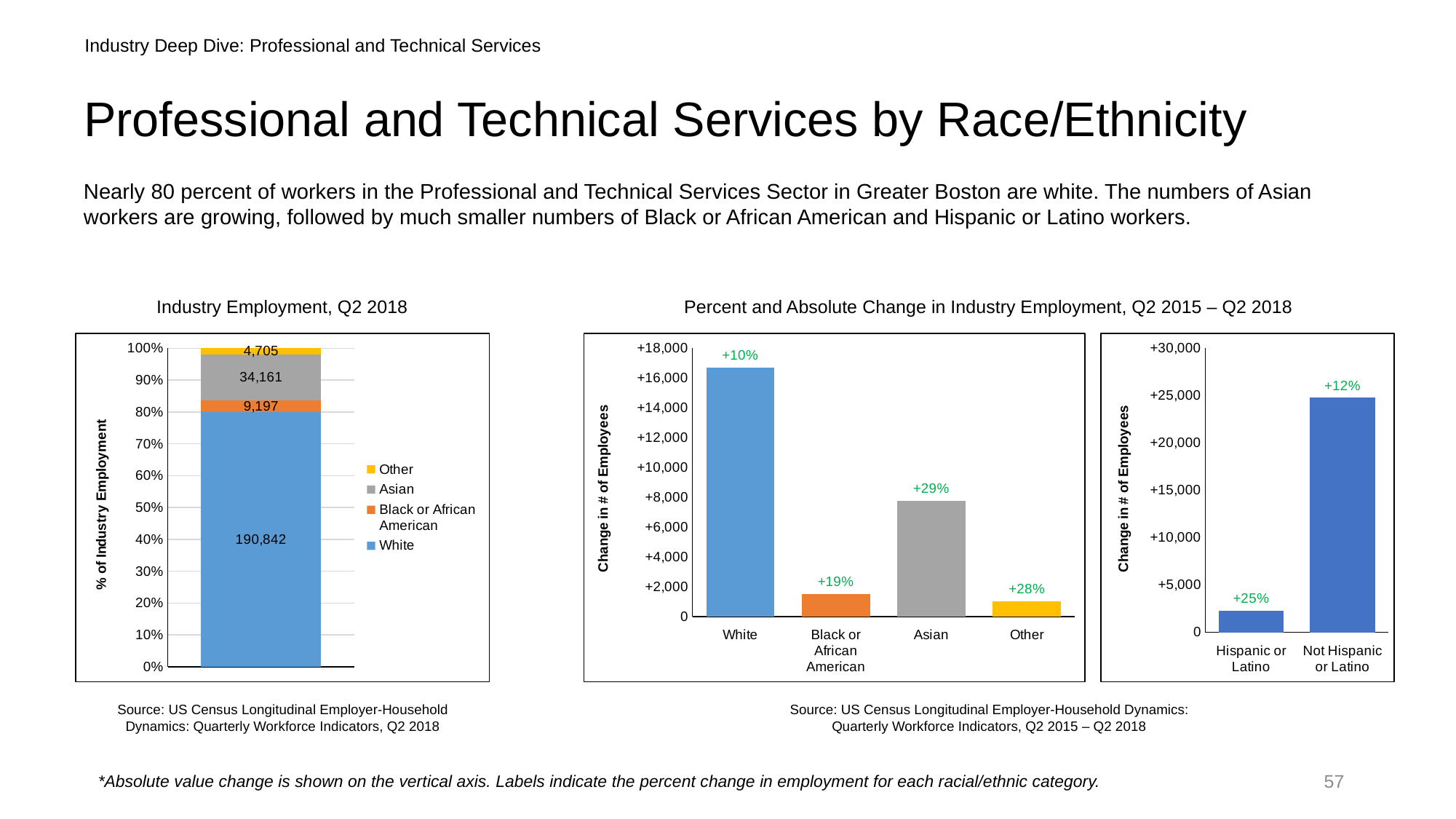
In the middle chart (Percent and Absolute Change in Industry Employment by race), is the bar for White greater or less than 14,000? greater In the rightmost chart (change in employment for Hispanic or Latino vs Not Hispanic or Latino), what percent change label is shown for Hispanic or Latino? +25% How many series does the legend of the 'Industry Employment, Q2 2018' chart list? 4 In the 'Industry Employment, Q2 2018' chart, what is the difference between the Asian value and the Black or African American value? 24,964 In the middle chart (Percent and Absolute Change in Industry Employment by race), what percent change label is shown for Asian? +29% In the 'Industry Employment, Q2 2018' chart, what is the value shown for Asian? 34,161 In the middle chart (Percent and Absolute Change in Industry Employment by race), is the bar for Asian greater or less than 6,000? greater In the 'Industry Employment, Q2 2018' chart, what is the value shown for White? 190,842 In the middle chart (Percent and Absolute Change in Industry Employment by race), which category has the tallest bar? White How many categories are shown on the x axis of the middle chart (Percent and Absolute Change in Industry Employment by race)? 4 In the rightmost chart (change in employment for Hispanic or Latino vs Not Hispanic or Latino), which category has the taller bar? Not Hispanic or Latino In the 'Industry Employment, Q2 2018' chart, what is the total of all four segments in the stacked bar? 238,905